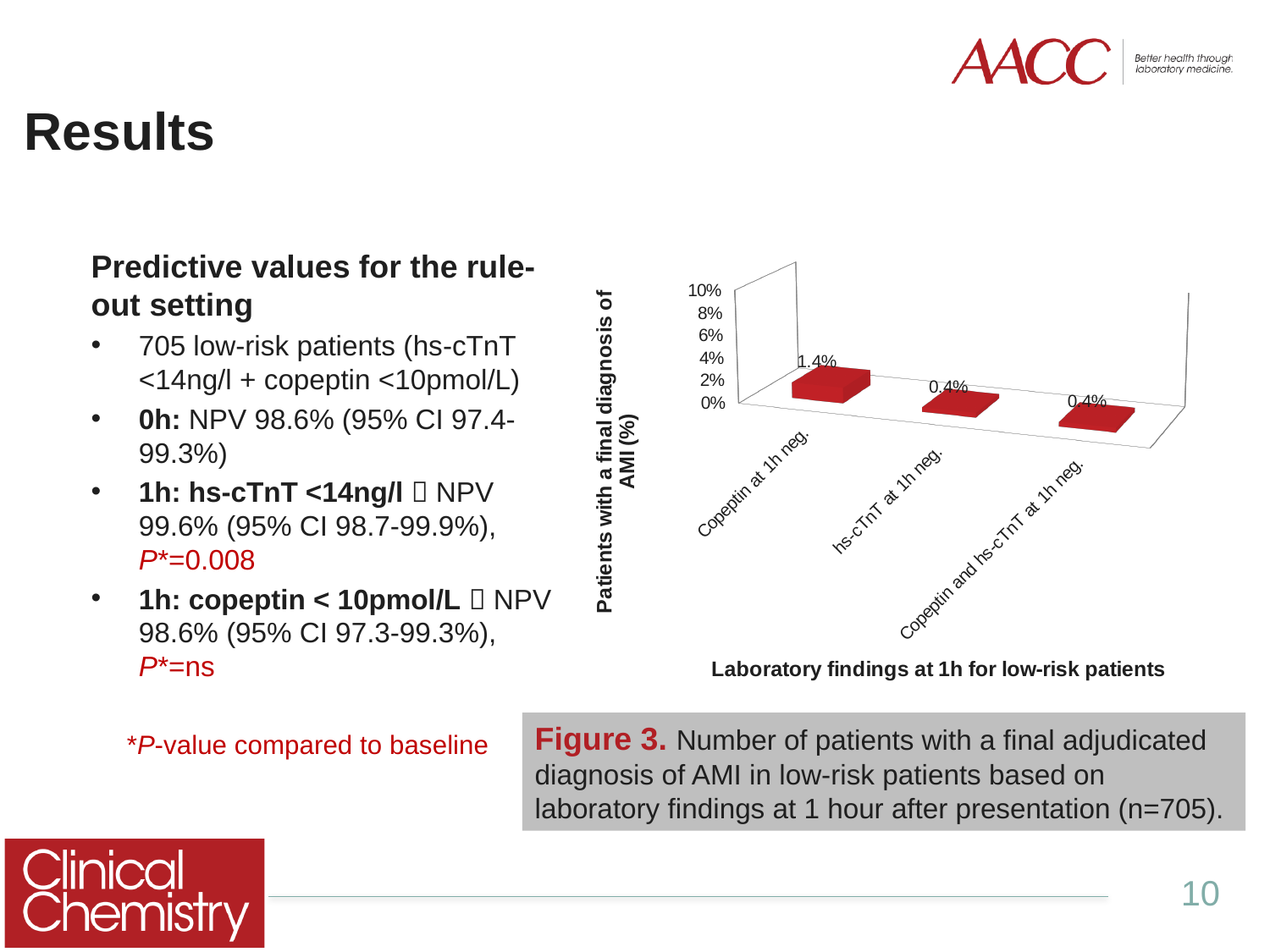
Which is larger, the value for Copeptin at 1h neg. or the value for hs-cTnT at 1h neg.? Copeptin at 1h neg. How many categories are shown on the x axis of the chart? 3 What is the highest tick value shown on the vertical axis? 10% What is the title of the horizontal axis of the chart? Laboratory findings at 1h for low-risk patients What kind of chart is shown on the slide? bar chart What is the title of the vertical axis of the chart? Patients with a final diagnosis of AMI (%) What is the value for Copeptin and hs-cTnT at 1h neg.? 0.4% What is the value for hs-cTnT at 1h neg.? 0.4% What is the value for Copeptin at 1h neg.? 1.4% Is the value for Copeptin at 1h neg. greater or less than 2%? less Which category has the highest percentage of patients with a final diagnosis of AMI? Copeptin at 1h neg. What is the difference between the values for Copeptin at 1h neg. and hs-cTnT at 1h neg.? 1.0%